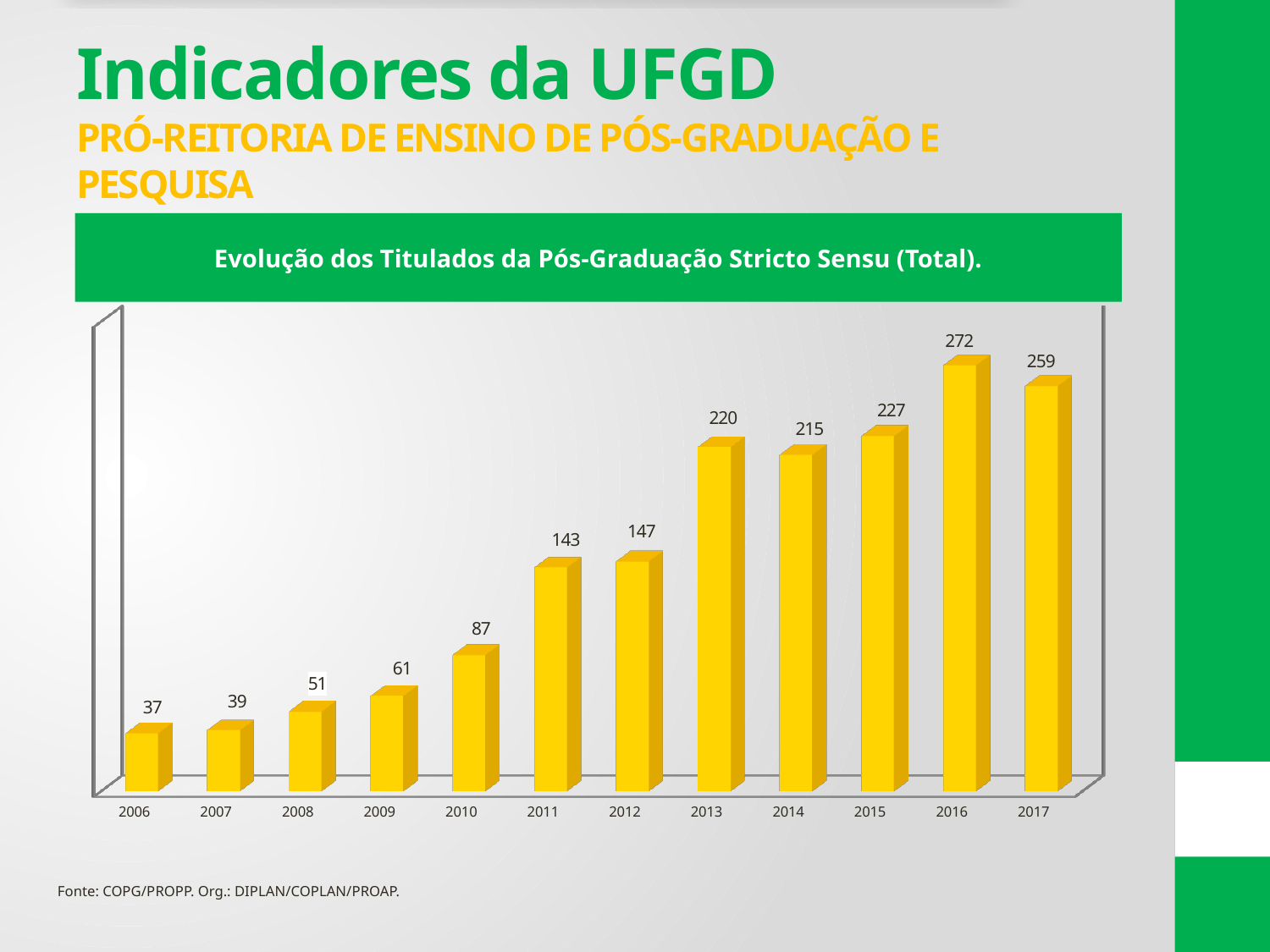
Which year has the highest value? 2016 What is the title of the chart? Evolução dos Titulados da Pós-Graduação Stricto Sensu (Total). What is the difference between the values for 2016 and 2017? 13 Which is larger, the value for 2014 or the value for 2015? 2015 What is the value for 2012? 147 What kind of chart is this? bar chart How many years are shown on the x axis? 12 What is the difference between the values for 2013 and 2012? 73 What is the value for 2017? 259 Which year has the lowest value? 2006 What is the value for 2006? 37 Do the values generally rise or fall from 2006 to 2016? rise